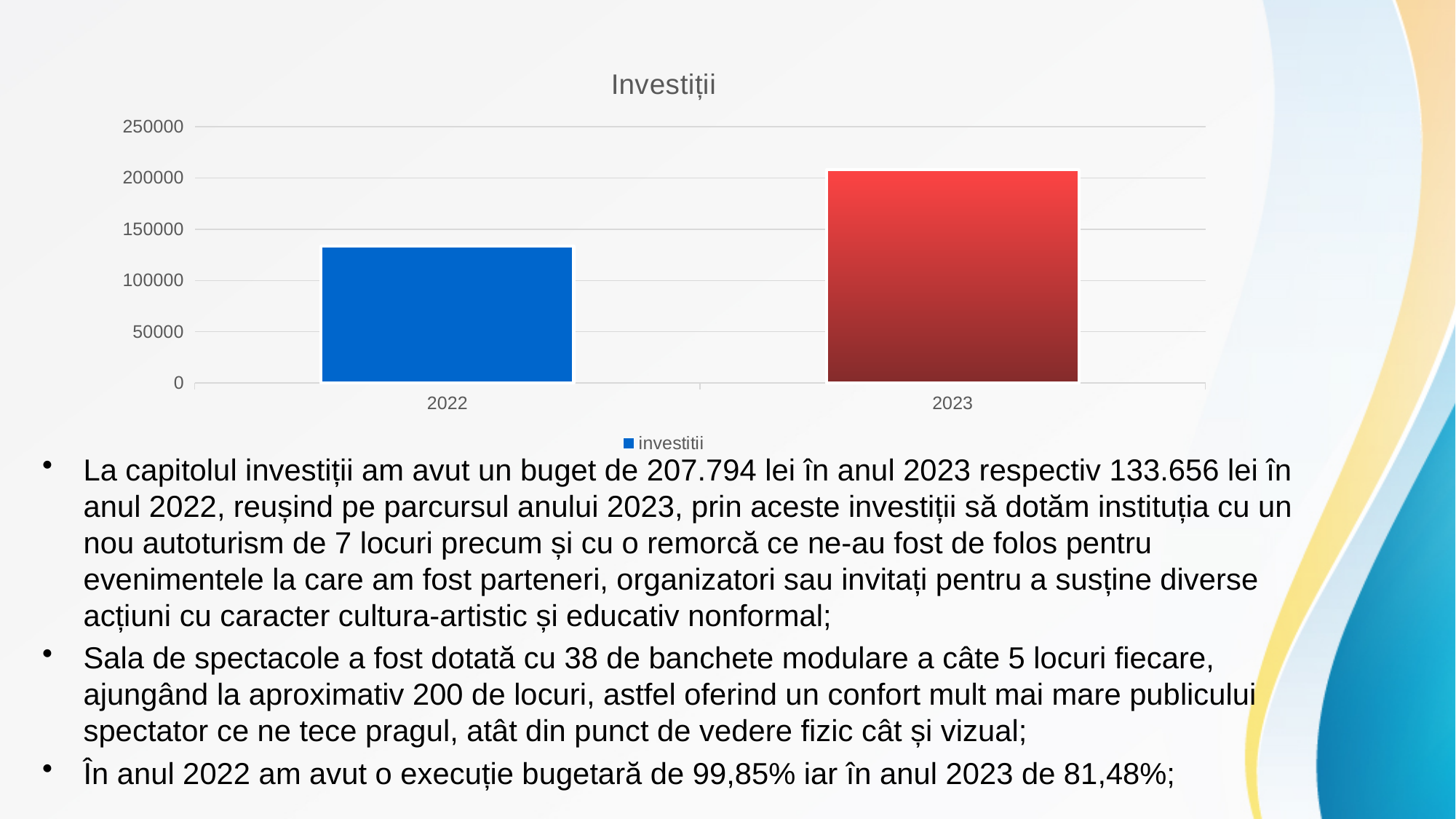
What is the name of the series in the chart legend? investitii How many categories are shown on the x axis of the chart? 2 Do the values rise or fall from 2022 to 2023? rise Which year has the highest value in the chart? 2023 Is the value for 2022 greater or less than 150000? less What type of chart is shown on the slide? bar chart Is the value for 2022 greater or less than 100000? greater Which year has the lowest value in the chart? 2022 What is the title of the chart? Investiții Is the value for 2023 greater or less than 200000? greater Which is larger, the value for 2022 or the value for 2023? 2023 How many series does the chart legend list? 1